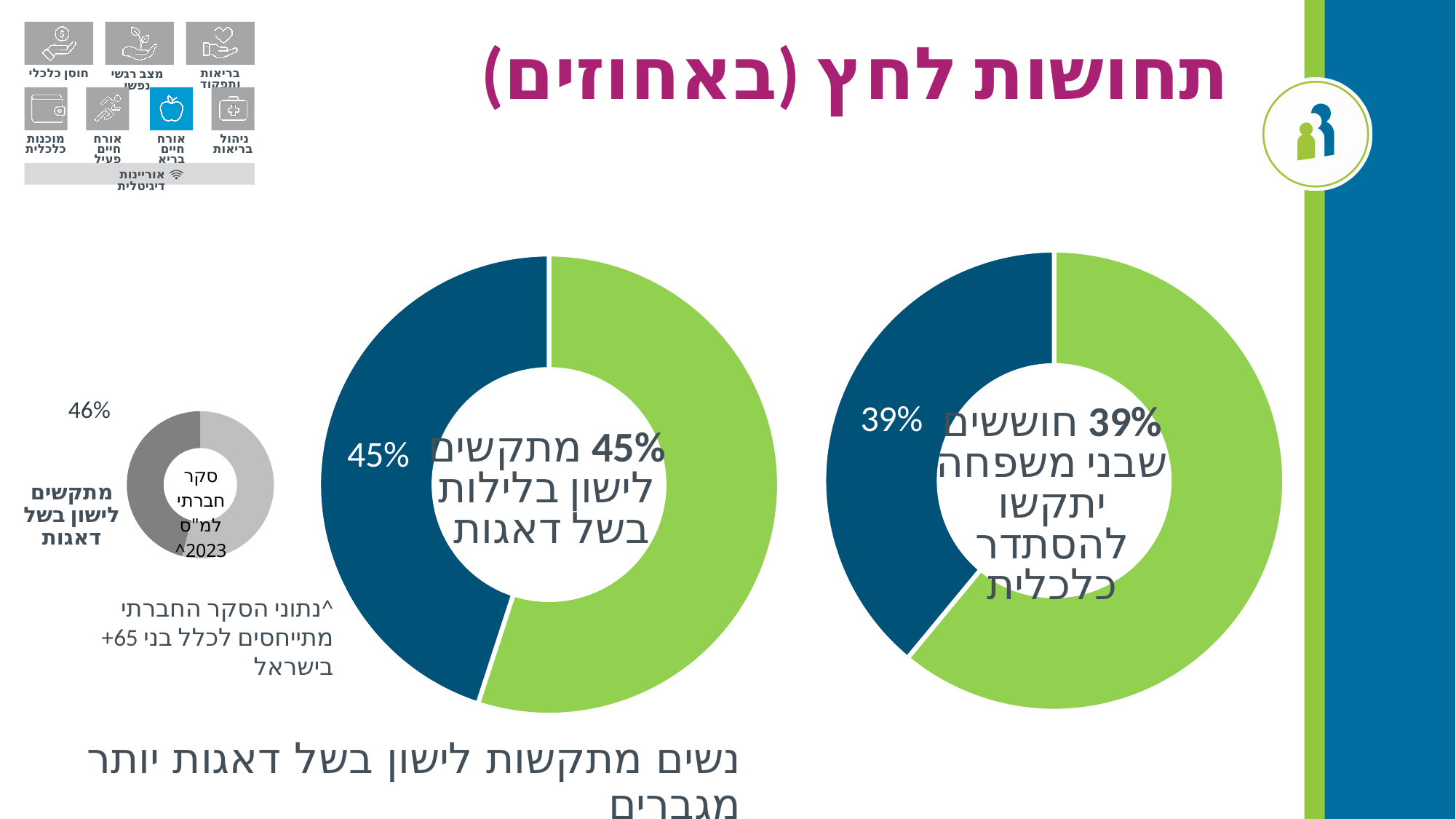
In the small grey chart on the left (מתקשים לישון בשל דאגות, סקר חברתי למ"ס 2023), what percentage is shown? 46% What kind of chart is the large chart in the centre of the slide (labelled 45%)? Donut (pie) chart What is the title of the slide? תחושות לחץ (באחוזים) In the right-hand chart (חוששים שבני משפחה יתקשו להסתדר כלכלית), what percentage is shown for the dark blue slice? 39% In the right-hand chart, what share of the donut does the green (unlabelled) slice represent? 61% What colour is the slice labelled 39% in the right-hand chart? Dark blue Which is larger: the 45% value in the centre chart or the 39% value in the right-hand chart? The centre chart (45%) What is the difference in percentage points between the centre chart's value (45%) and the right-hand chart's value (39%)? 6 percentage points In the centre chart, what share of the donut does the green (unlabelled) slice represent? 55% In the centre chart, is the dark blue slice (45%) greater or less than 50% of the donut? less How many donut charts are shown on the slide? 3 In the centre chart, what percentage is shown for the dark blue slice (מתקשים לישון בלילות בשל דאגות)? 45%